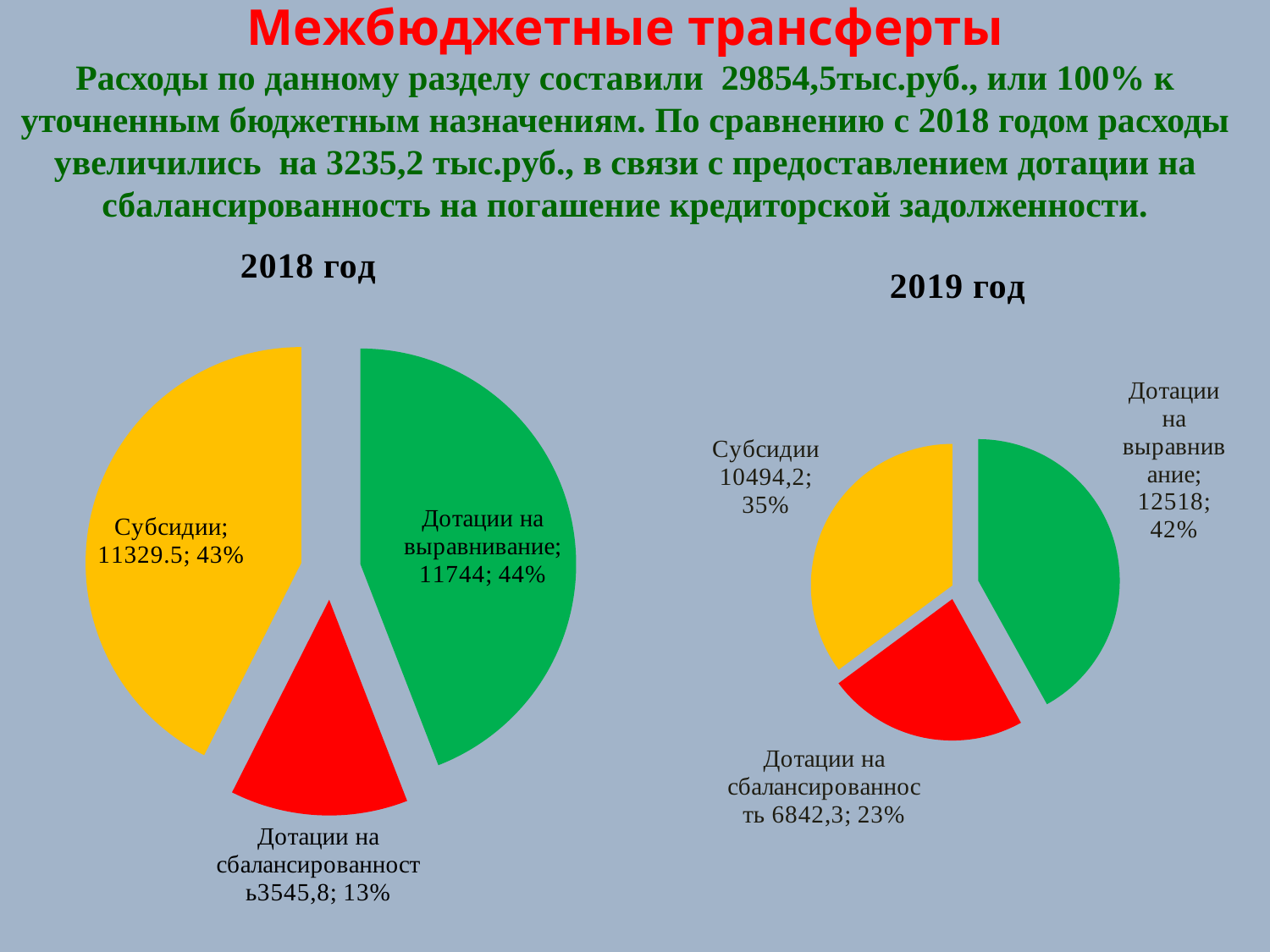
What type of chart is the "2019 год" chart? Pie chart In the "2018 год" chart, what share of the pie is Дотации на выравнивание? 44% In the "2018 год" chart, which category has the smallest slice? Дотации на сбалансированность In the "2019 год" chart, what value is shown for Дотации на сбалансированность? 6842,3; 23% In the "2018 год" chart, what value is shown for Субсидии? 11329.5; 43% In the "2018 год" chart, what value is shown for Дотации на сбалансированность? 3545,8; 13% In the "2019 год" chart, what share of the pie is Субсидии? 35% In the "2018 год" chart, what colour is the Субсидии slice? Yellow How many slices does the "2018 год" chart have? 3 In the "2019 год" chart, which category has the largest slice? Дотации на выравнивание In the "2019 год" chart, which is larger, Субсидии or Дотации на сбалансированность? Субсидии In the "2019 год" chart, what value is shown for Дотации на выравнивание? 12518; 42%